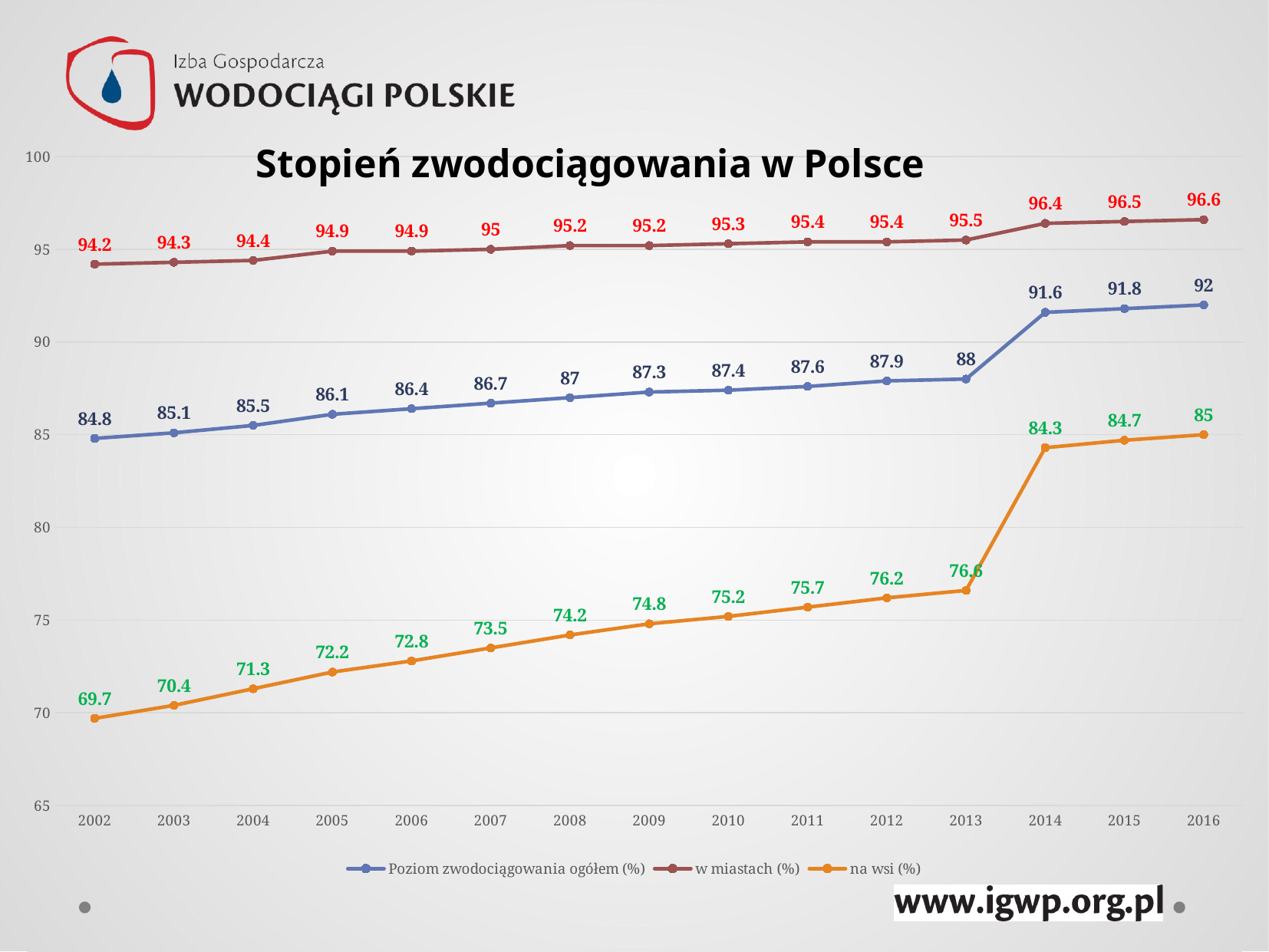
What is the difference between the 'na wsi (%)' values for 2014 and 2013? 7.7 In which year is the 'na wsi (%)' series at its lowest? 2002 In which year is the 'Poziom zwodociągowania ogółem (%)' series at its highest? 2016 What type of chart is shown on the slide? line chart How many years are shown on the x axis? 15 What is the value for 'Poziom zwodociągowania ogółem (%)' in 2010? 87.4 What is the value for 'w miastach (%)' in 2016? 96.6 What is the title of the chart? Stopień zwodociągowania w Polsce Does the 'na wsi (%)' series rise or fall from 2002 to 2016? rise Which series has the higher value in 2008: 'w miastach (%)' or 'na wsi (%)'? w miastach (%) What is the value for 'na wsi (%)' in 2002? 69.7 How many series does the legend list? 3